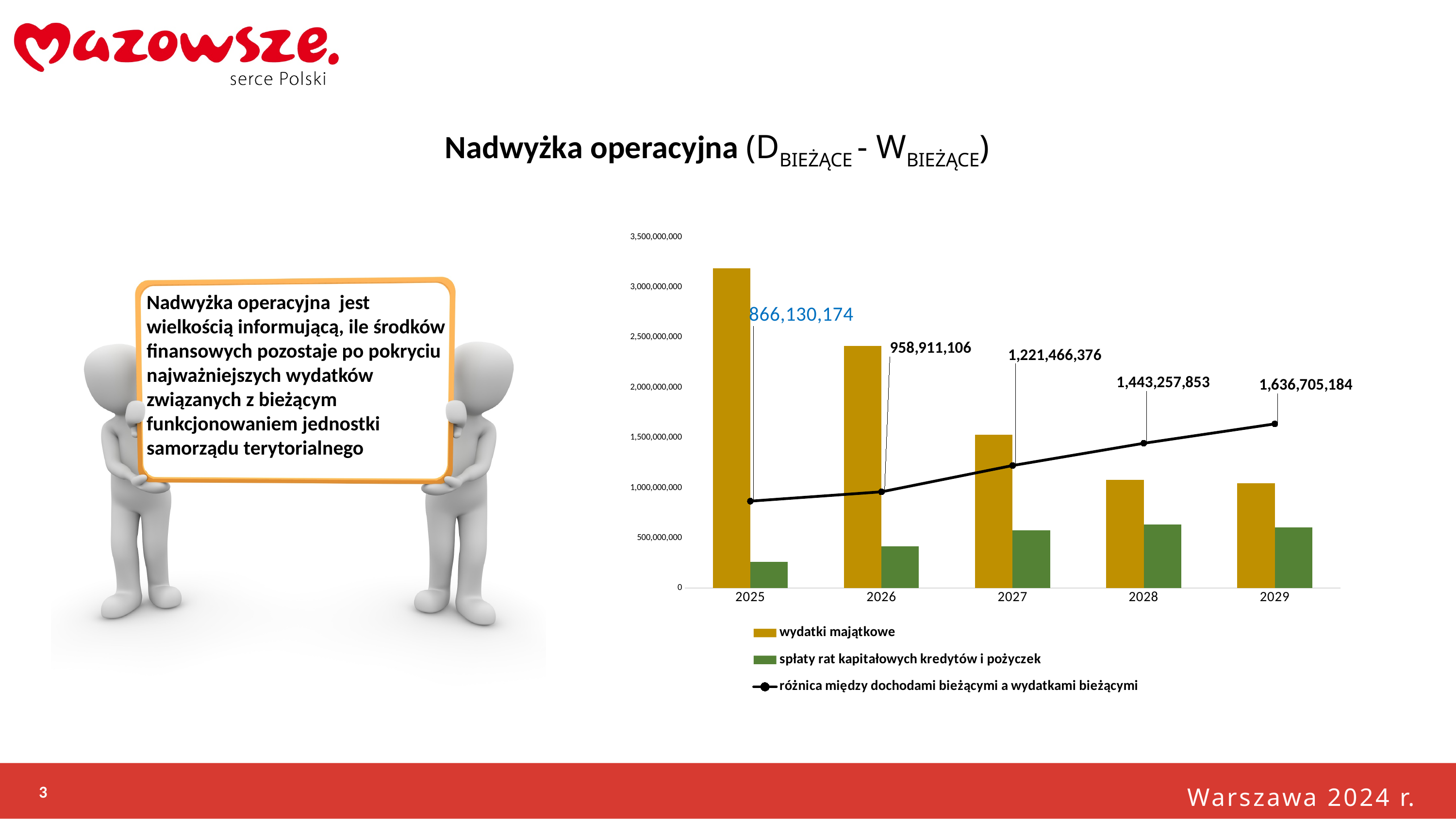
In which year is the line series 'różnica między dochodami bieżącymi a wydatkami bieżącymi' lowest? 2025 What is the value of the line series 'różnica między dochodami bieżącymi a wydatkami bieżącymi' for 2029? 1,636,705,184 What is the value of the line series 'różnica między dochodami bieżącymi a wydatkami bieżącymi' for 2027? 1,221,466,376 Is the value of 'wydatki majątkowe' for 2025 greater or less than 3,000,000,000? greater How many years are shown on the x axis of the chart? 5 In which year is the line series 'różnica między dochodami bieżącymi a wydatkami bieżącymi' highest? 2029 What is the value of the line series 'różnica między dochodami bieżącymi a wydatkami bieżącymi' for 2025? 866,130,174 How many series does the chart legend list? 3 Does the line series 'różnica między dochodami bieżącymi a wydatkami bieżącymi' rise or fall from 2025 to 2029? rise Is the value of 'spłaty rat kapitałowych kredytów i pożyczek' for 2025 greater or less than 500,000,000? less In which year is the 'wydatki majątkowe' bar the tallest? 2025 What is the difference between the 2029 and 2028 values of the line series 'różnica między dochodami bieżącymi a wydatkami bieżącymi'? 193,447,331